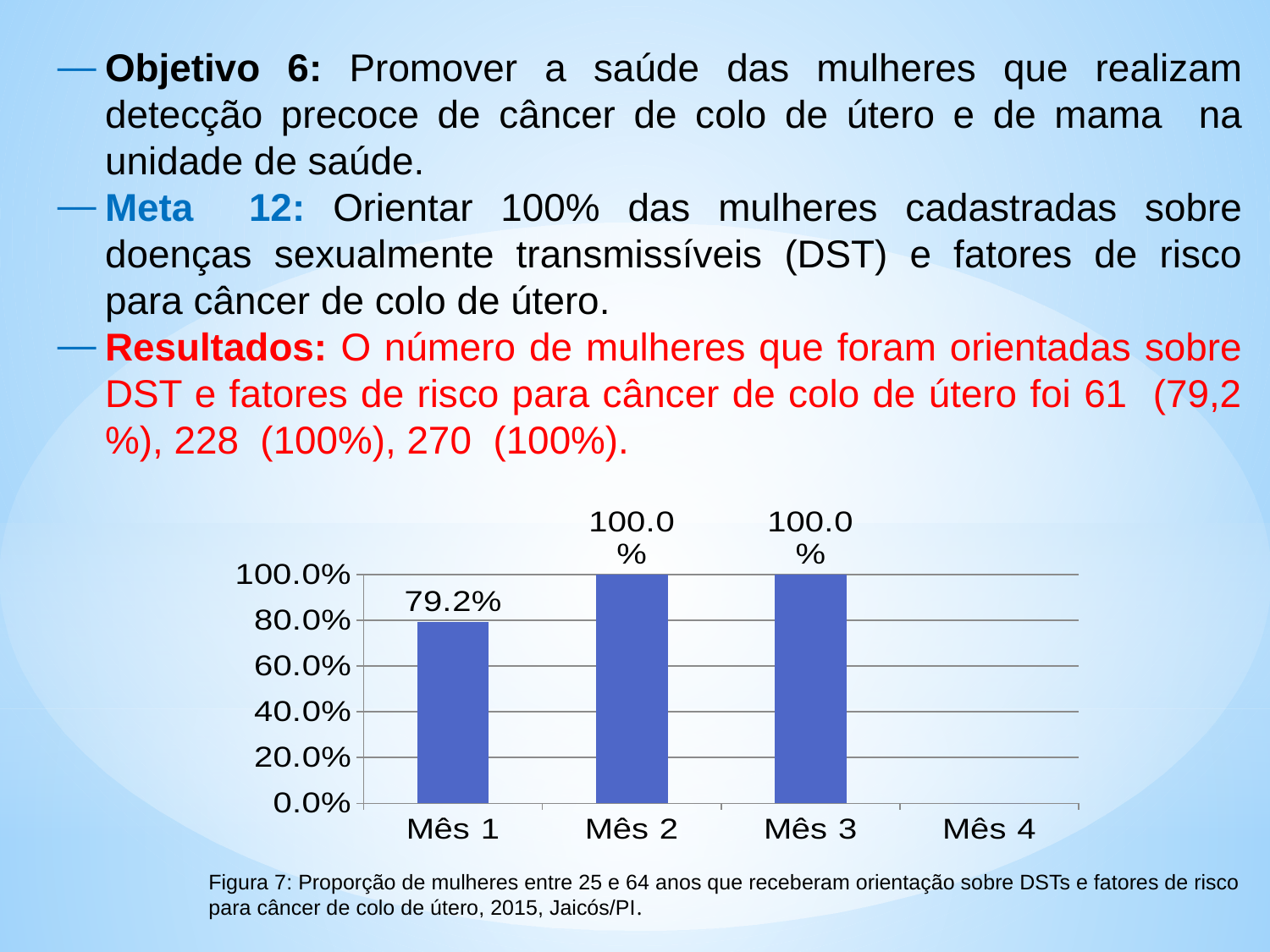
Do the values rise or fall from Mês 1 to Mês 2? rise What is the value for Mês 1? 79.2% Which category has the lowest value among the bars shown? Mês 1 Which category on the x axis has no bar plotted? Mês 4 What is the value for Mês 3? 100.0% What is the highest value shown on the y axis? 100.0% What is the difference between the values for Mês 2 and Mês 1? 20.8% What is the value for Mês 2? 100.0% Is the value for Mês 1 greater or less than 60.0%? greater What kind of chart is shown on the slide? bar chart Which is larger, the value for Mês 1 or the value for Mês 3? Mês 3 How many categories are shown on the x axis? 4